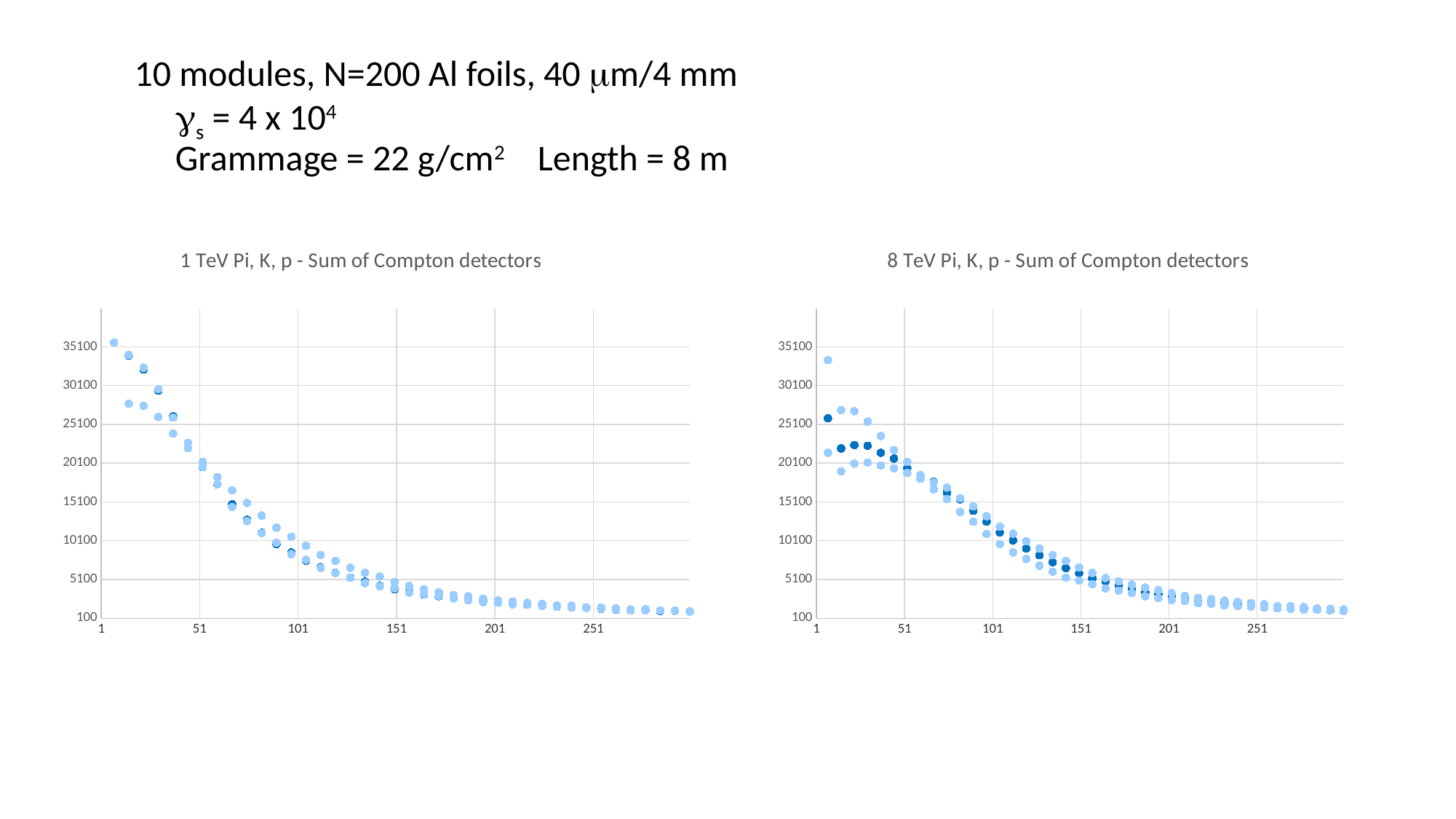
What kind of chart is the right chart titled "8 TeV Pi, K, p - Sum of Compton detectors"? scatter chart What is the title of the left chart? 1 TeV Pi, K, p - Sum of Compton detectors What is the highest labelled tick on the y axis of the right chart (8 TeV)? 35100 In the left chart (1 TeV), are the values at x = 251 greater or less than 5100? less In the left chart (1 TeV), is the highest point near x = 1 greater or less than 30100? greater In the right chart (8 TeV), are the values at x = 201 greater or less than 5100? less In the right chart (8 TeV), do the plotted values overall rise or fall as x increases from 51 onward? fall In the left chart (1 TeV), do the plotted values overall rise or fall as x increases? fall What kind of chart is the left chart titled "1 TeV Pi, K, p - Sum of Compton detectors"? scatter chart